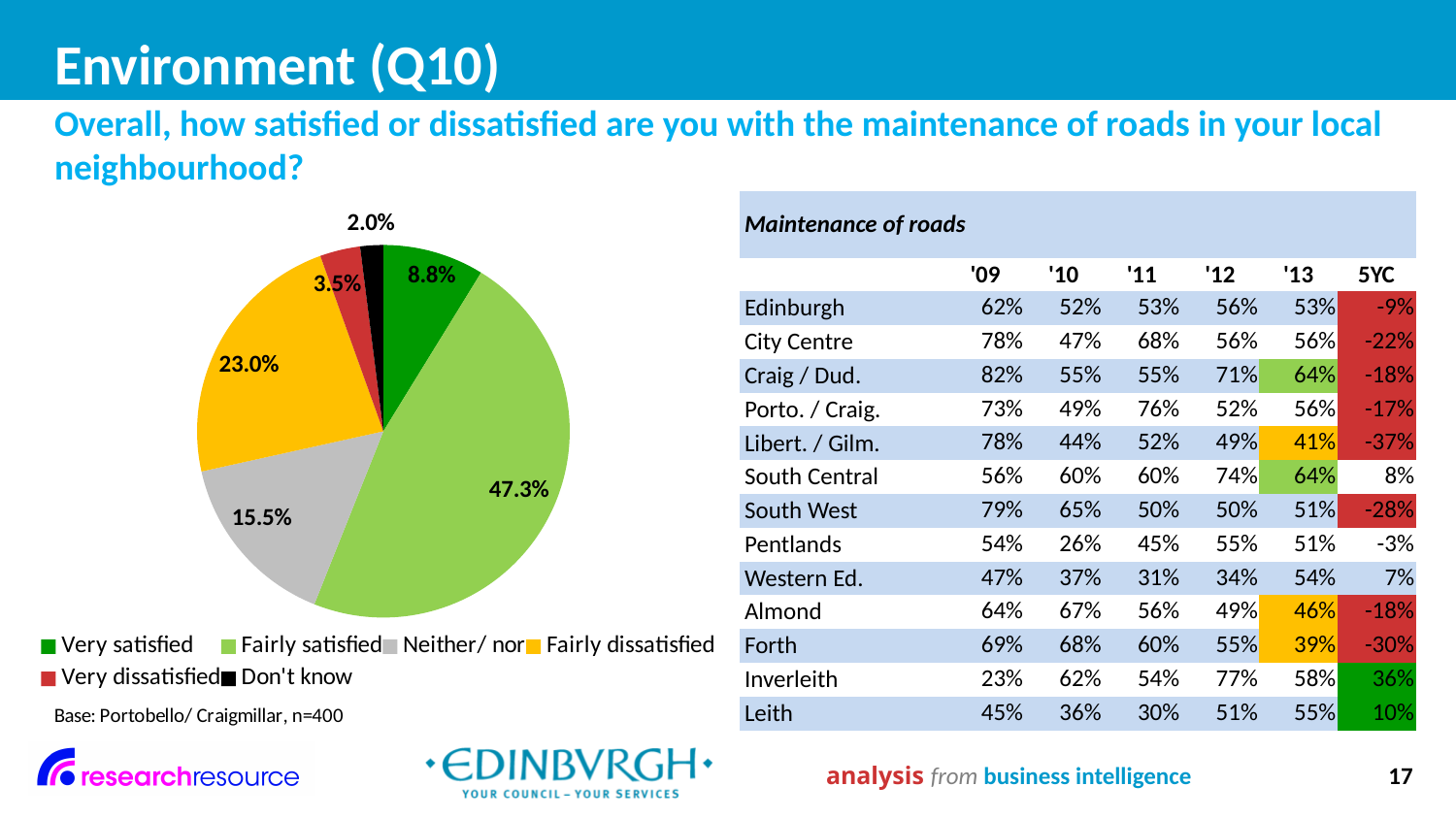
What is the difference between the 'Fairly satisfied' and 'Fairly dissatisfied' percentages? 24.3% What percentage of respondents are very satisfied? 8.8% How many categories does the pie chart legend list? 6 What percentage of respondents answered 'Don't know'? 2.0% Which category has the smallest slice of the pie? Don't know What is the base (sample size) stated below the pie chart? Portobello/ Craigmillar, n=400 Which is larger, 'Very satisfied' or 'Very dissatisfied'? Very satisfied What percentage of respondents are fairly dissatisfied? 23.0% What kind of chart is shown on the slide? Pie chart What percentage of respondents are fairly satisfied with the maintenance of roads? 47.3% What share of the pie is 'Neither/ nor'? 15.5% Which category has the largest slice of the pie? Fairly satisfied